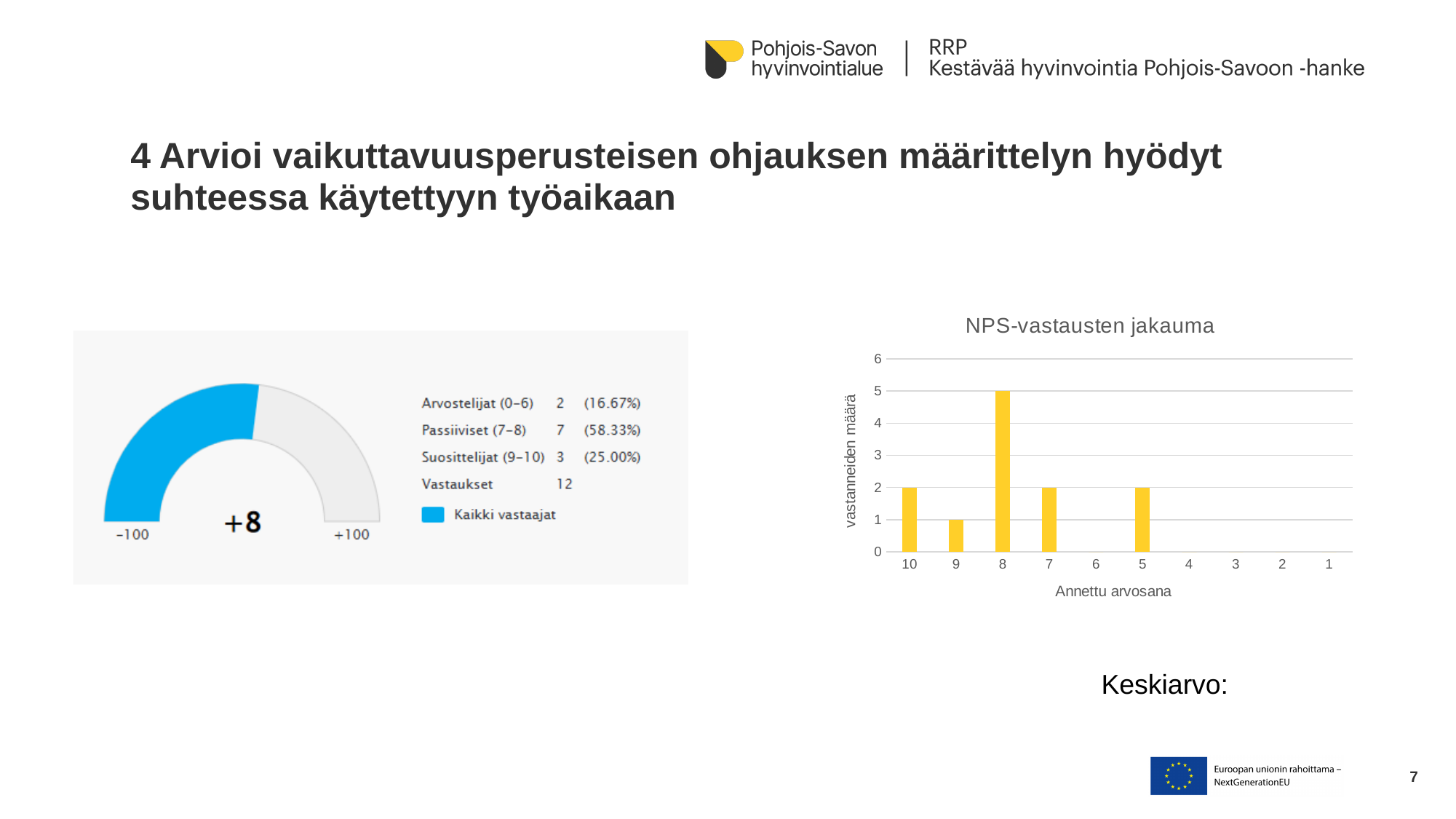
What NPS value is shown on the gauge chart on the left of the slide? +8 In the bar chart 'NPS-vastausten jakauma', how many respondents gave the score 8? 5 In the bar chart 'NPS-vastausten jakauma', how many respondents gave the score 9? 1 In the bar chart 'NPS-vastausten jakauma', how many score categories are shown on the x axis? 10 In the bar chart 'NPS-vastausten jakauma', which score received the most responses? 8 On the gauge chart on the left, what percentage of respondents are Passiiviset (7–8)? 58.33% What kind of chart is 'NPS-vastausten jakauma'? bar chart In the bar chart 'NPS-vastausten jakauma', is the value for score 8 greater or less than 4? greater In the bar chart 'NPS-vastausten jakauma', what is the difference between the number of responses for score 8 and score 10? 3 In the bar chart 'NPS-vastausten jakauma', which score has more responses, 10 or 9? 10 On the gauge chart on the left, how many responses (Vastaukset) are there in total? 12 What is the title of the bar chart on the right of the slide? NPS-vastausten jakauma